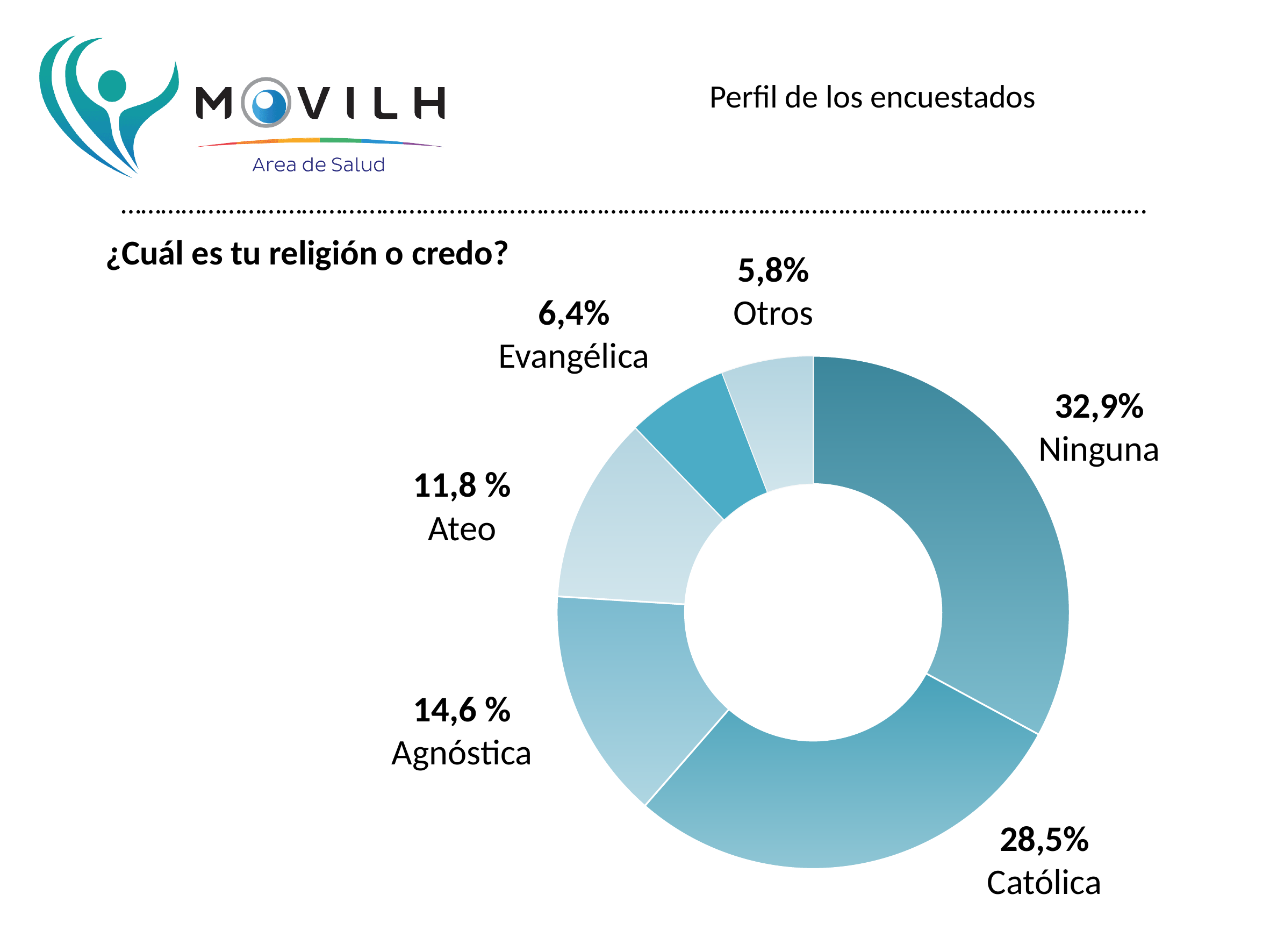
Which religion or creed category has the smallest share of respondents? Otros How many religion or creed categories are shown in the chart? 6 Which category has a larger share, Agnóstica or Ateo? Agnóstica How many percentage points higher is Ninguna than Católica? 4,4 What share of respondents identified as Católica? 28,5% What percentage of respondents identified as Evangélica? 6,4% What percentage of respondents identified as Ateo? 11,8 % What percentage of respondents fall under "Otros"? 5,8% What percentage of respondents identified as Agnóstica? 14,6 % Which religion or creed category has the largest share of respondents? Ninguna What percentage of respondents answered "Ninguna" to the question "¿Cuál es tu religión o credo?"? 32,9% What type of chart is used to show the religion or creed of respondents? Doughnut (pie) chart